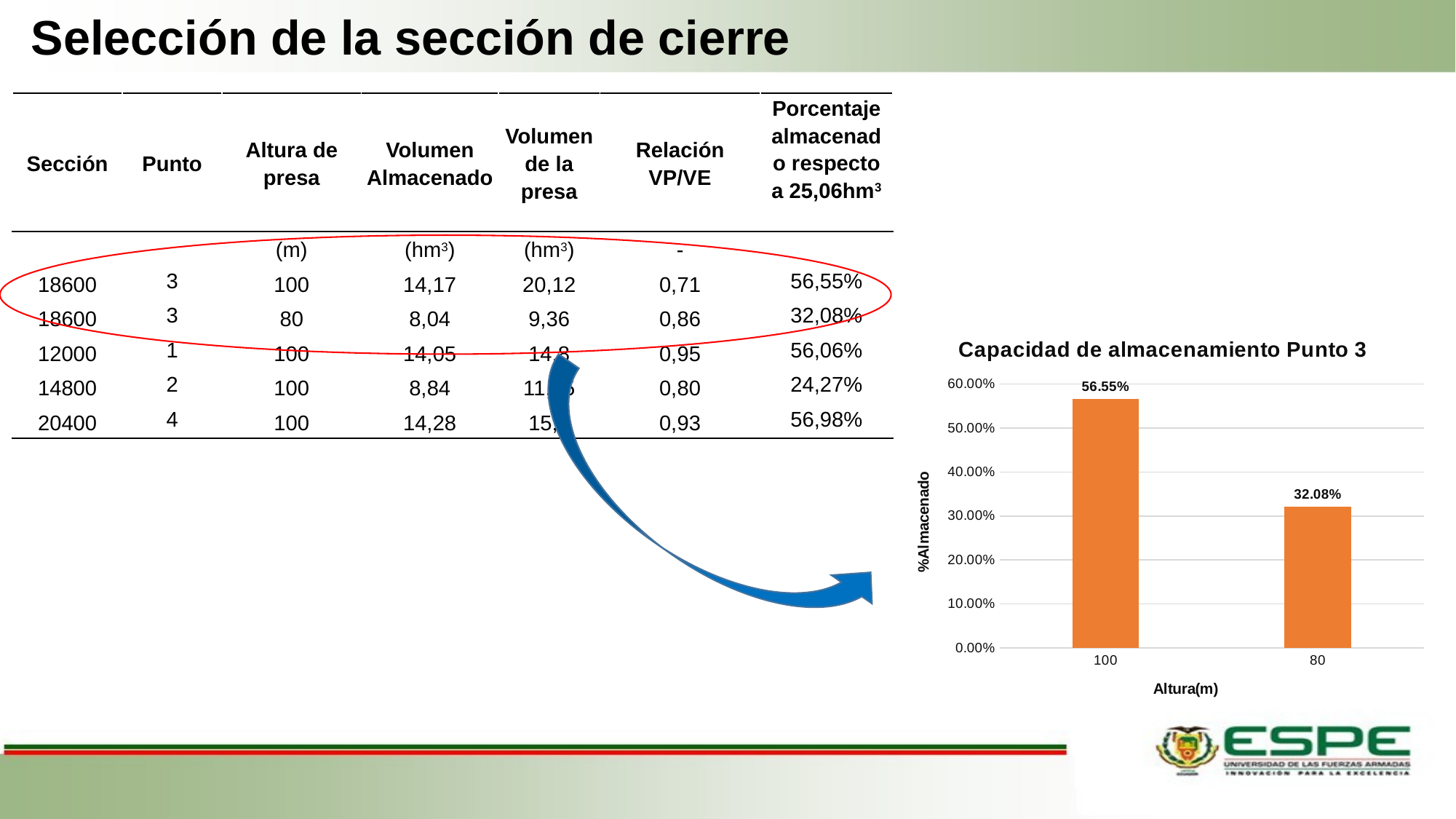
Is the value for 100 m greater or less than 50.00%? greater What is the title of the chart? Capacidad de almacenamiento Punto 3 Which height has the highest stored percentage in the chart? 100 What kind of chart is shown on the slide? bar chart How many bars are plotted in the chart? 2 What is the value for the 100 m height in the chart? 56.55% What is the label of the x axis of the chart? Altura(m) Which is larger in the chart, the value for 100 m or for 80 m? 100 Which height has the lowest stored percentage in the chart? 80 What is the difference between the values for 100 m and 80 m in the chart? 24.47% Is the value for 80 m greater or less than 40.00%? less What is the value for the 80 m height in the chart? 32.08%